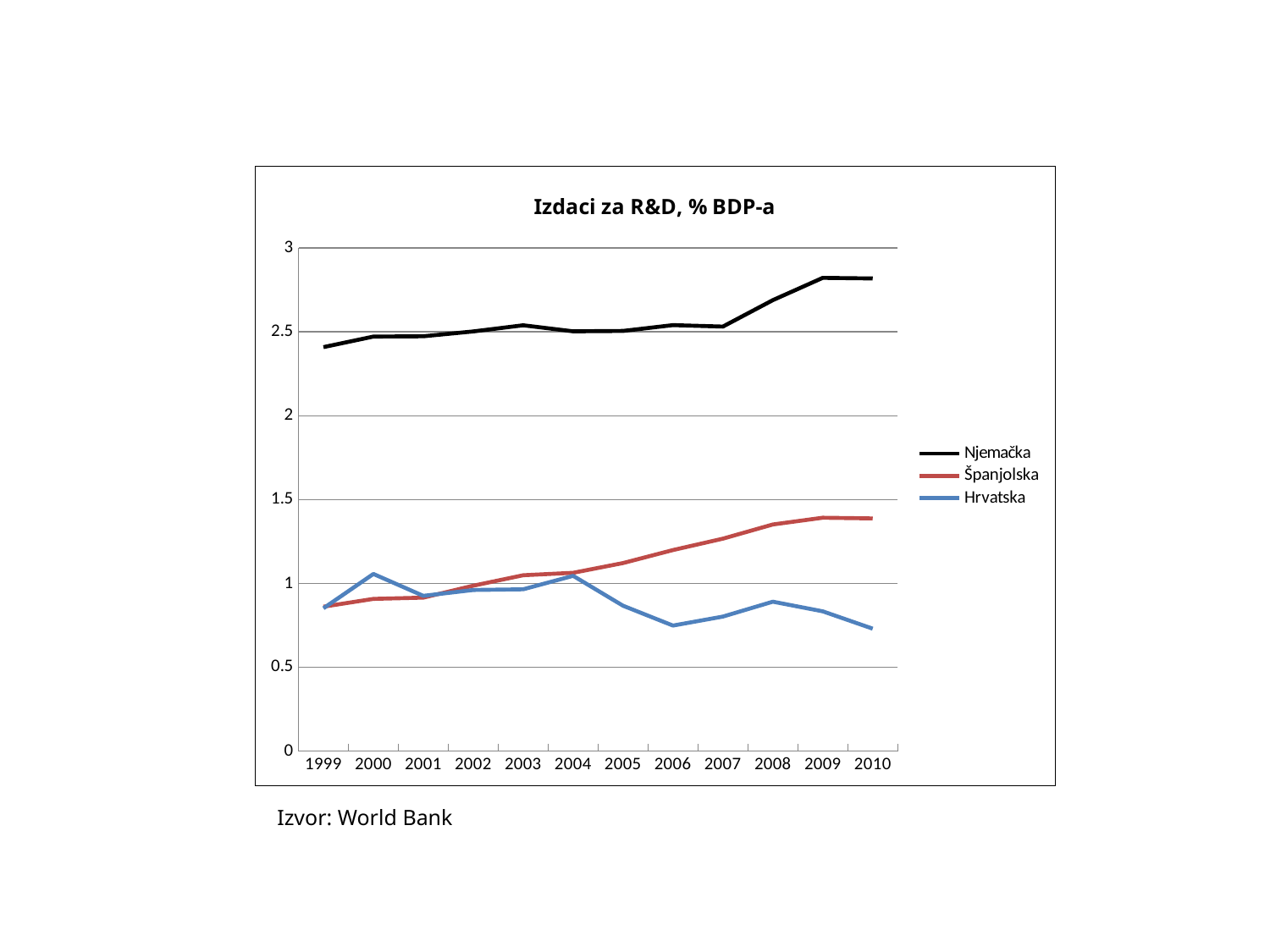
Does the value for Španjolska rise or fall from 1999 to 2010? rise Is the value for Njemačka in 1999 greater or less than 2.5? less Is the value for Njemačka in 2010 greater or less than 2.5? greater Which series has the highest value in 2010? Njemačka Is the value for Hrvatska in 2010 greater or less than 1? less How many series does the legend list? 3 Which is larger in 2010, the value for Španjolska or the value for Hrvatska? Španjolska Which series is drawn with the red line? Španjolska Which series has the lowest value in 2010? Hrvatska How many years are shown on the x axis? 12 What is the title of the chart? Izdaci za R&D, % BDP-a What kind of chart is shown on the slide? line chart